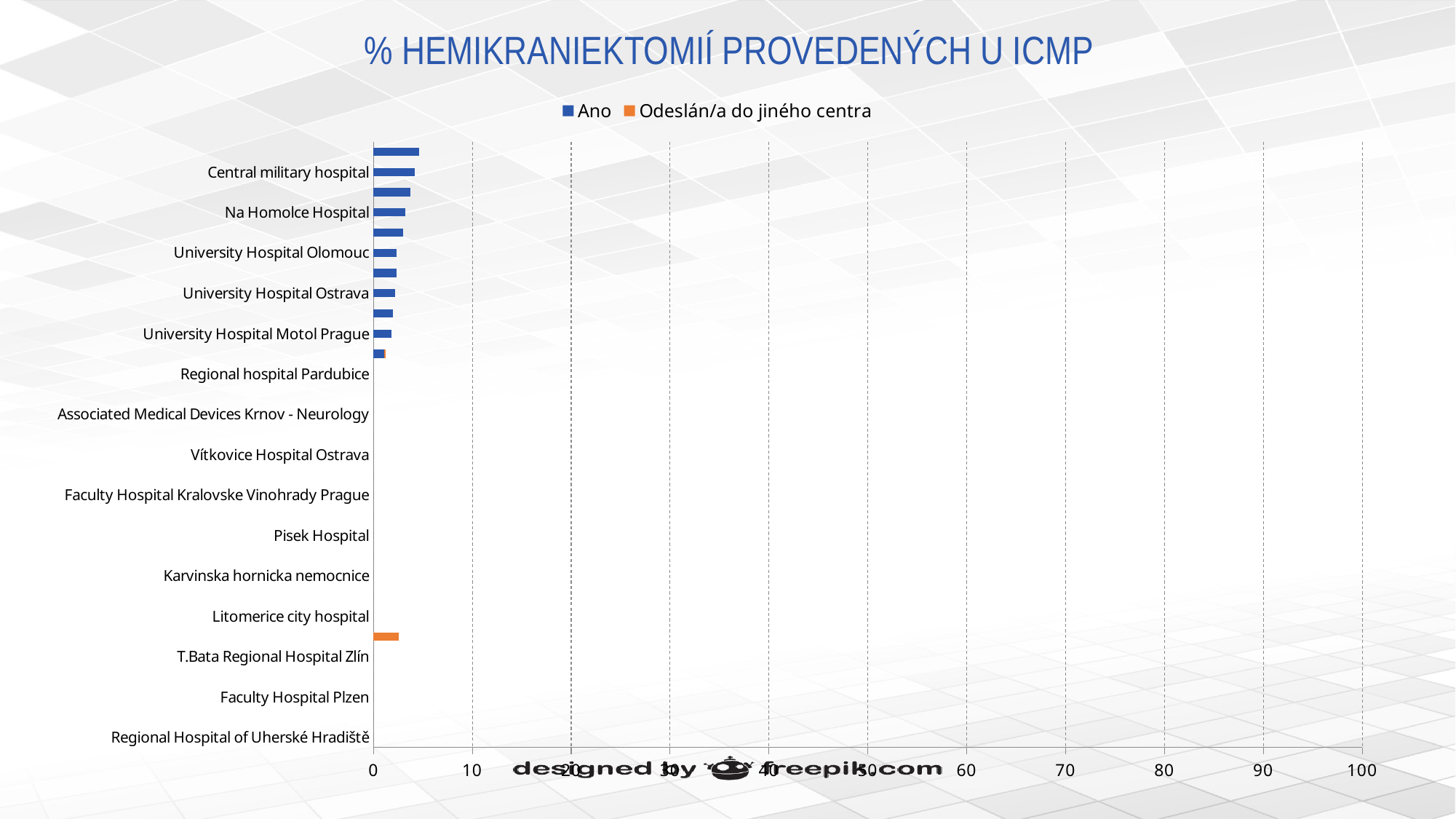
What is the highest value shown on the horizontal axis? 100 Is the value for Central military hospital greater or less than 10? less How many series does the legend list? 2 Which has the larger Ano value, Na Homolce Hospital or University Hospital Motol Prague? Na Homolce Hospital What kind of chart is shown on the slide? bar chart Is the value for University Hospital Motol Prague greater or less than 10? less What is the title of the chart? % HEMIKRANIEKTOMIÍ PROVEDENÝCH U ICMP Which has the larger Ano value, Central military hospital or University Hospital Motol Prague? Central military hospital What are the two series named in the legend? Ano; Odeslán/a do jiného centra Is the value for Na Homolce Hospital greater or less than 10? less